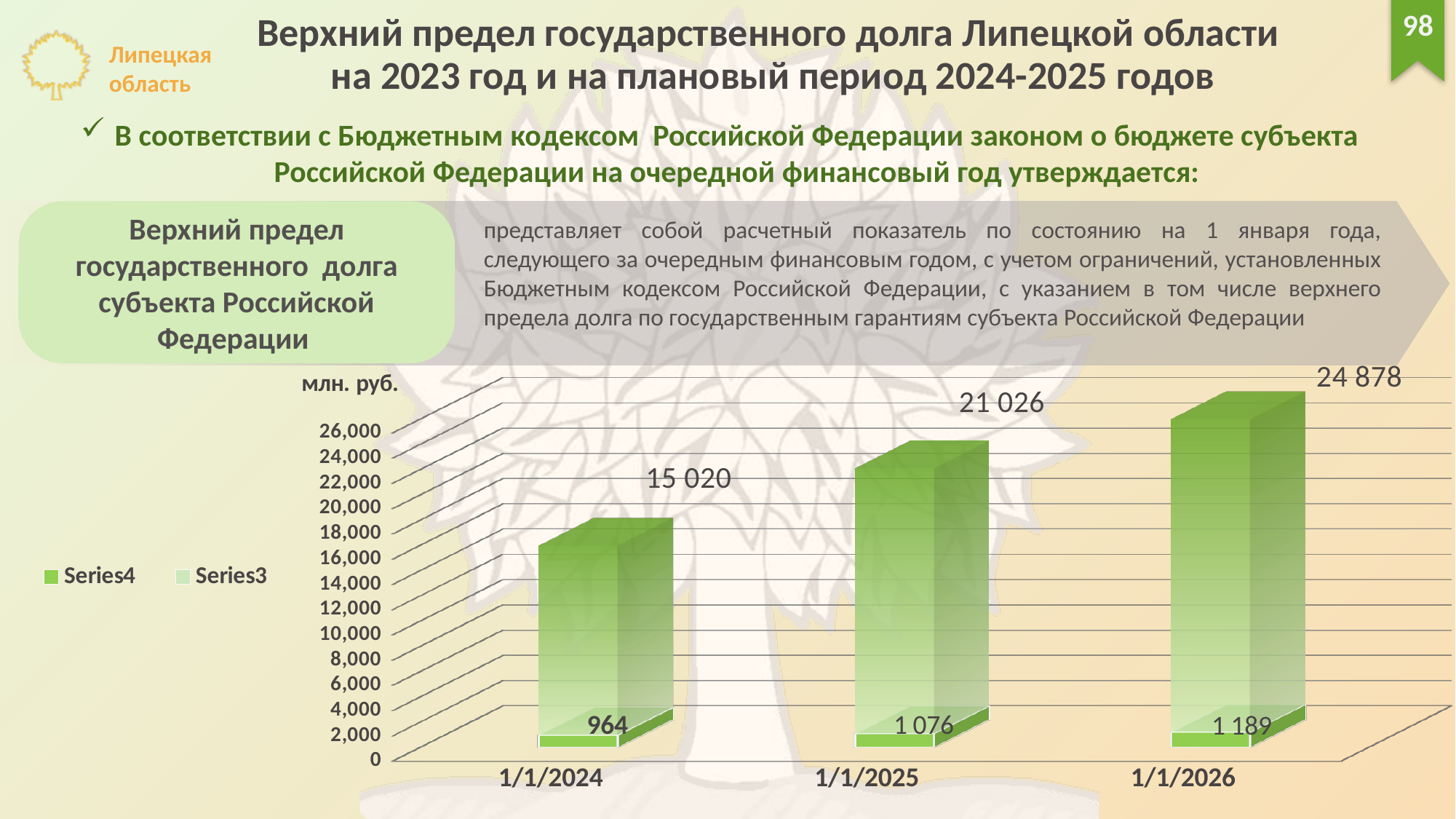
What is the difference between the tall bar values for 1/1/2025 and 1/1/2024? 6 006 How many categories are shown on the x axis of the chart? 3 What is the value of the tall bar for 1/1/2026? 24 878 What is the difference between the small bar values for 1/1/2026 and 1/1/2024? 225 What unit is indicated above the vertical axis of the chart? млн. руб. How many series does the chart legend list? 2 Do the tall bar values rise or fall from 1/1/2024 to 1/1/2026? rise What type of chart is shown on the slide? bar chart What is the value of the tall bar for 1/1/2024? 15 020 What is the value of the small bar for 1/1/2025? 1 076 Which date has the highest value among the tall bars? 1/1/2026 Which date has the lowest value among the small bars? 1/1/2024